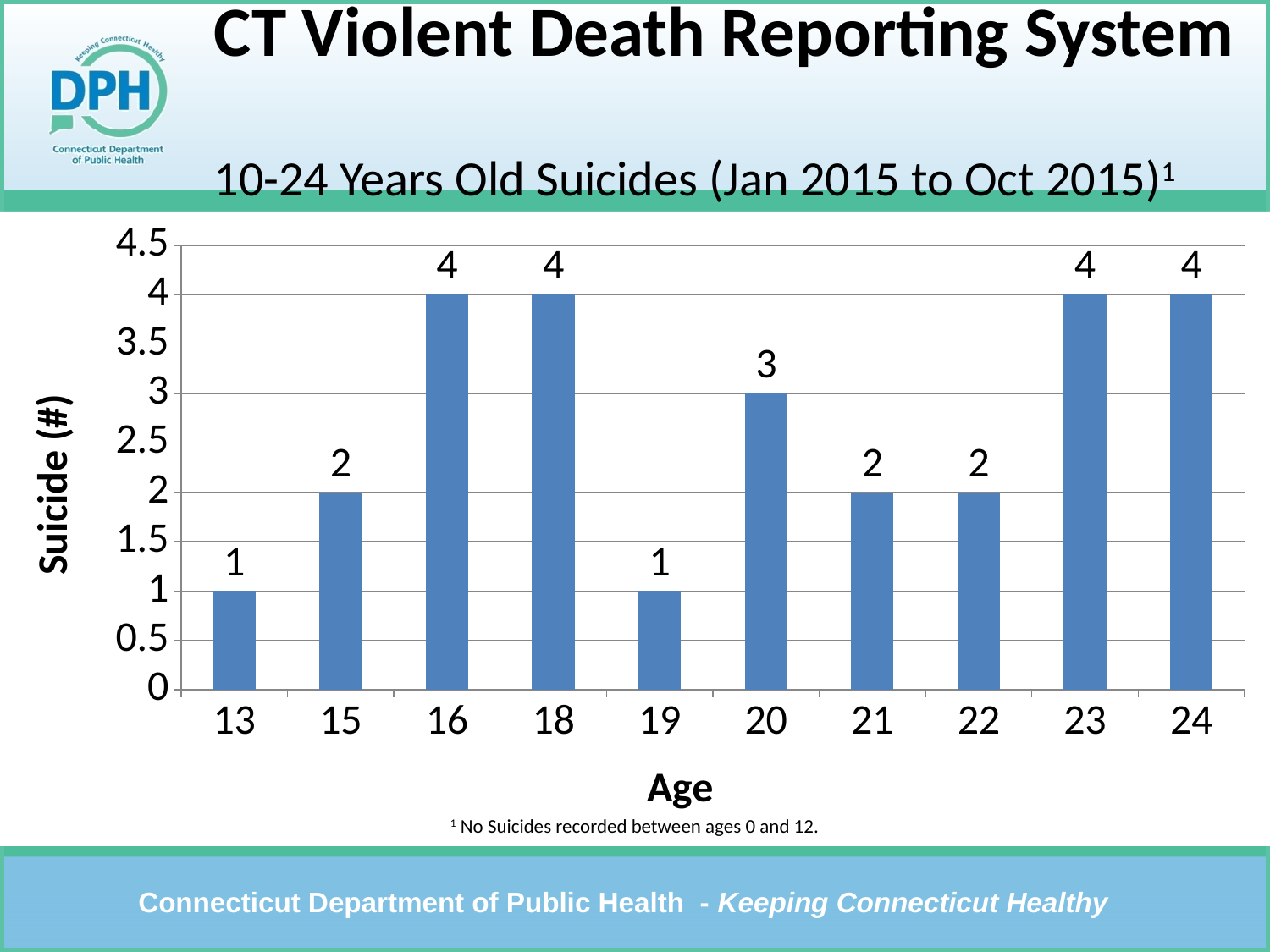
What is the difference in suicides between age 16 and age 15? 2 What is the title of the chart? 10-24 Years Old Suicides (Jan 2015 to Oct 2015) What is the difference in suicides between age 20 and age 19? 2 How many age categories are shown on the x axis? 10 What is the highest number of suicides shown for any single age? 4 Which age has the lowest number of suicides, 19 or 21? 19 What is the number of suicides for age 13? 1 What is the label of the y axis? Suicide (#) What kind of chart is shown on the slide? Bar chart How many suicides are shown for age 22? 2 How many suicides are shown for age 20? 3 Is the value for age 18 greater or less than 3? greater